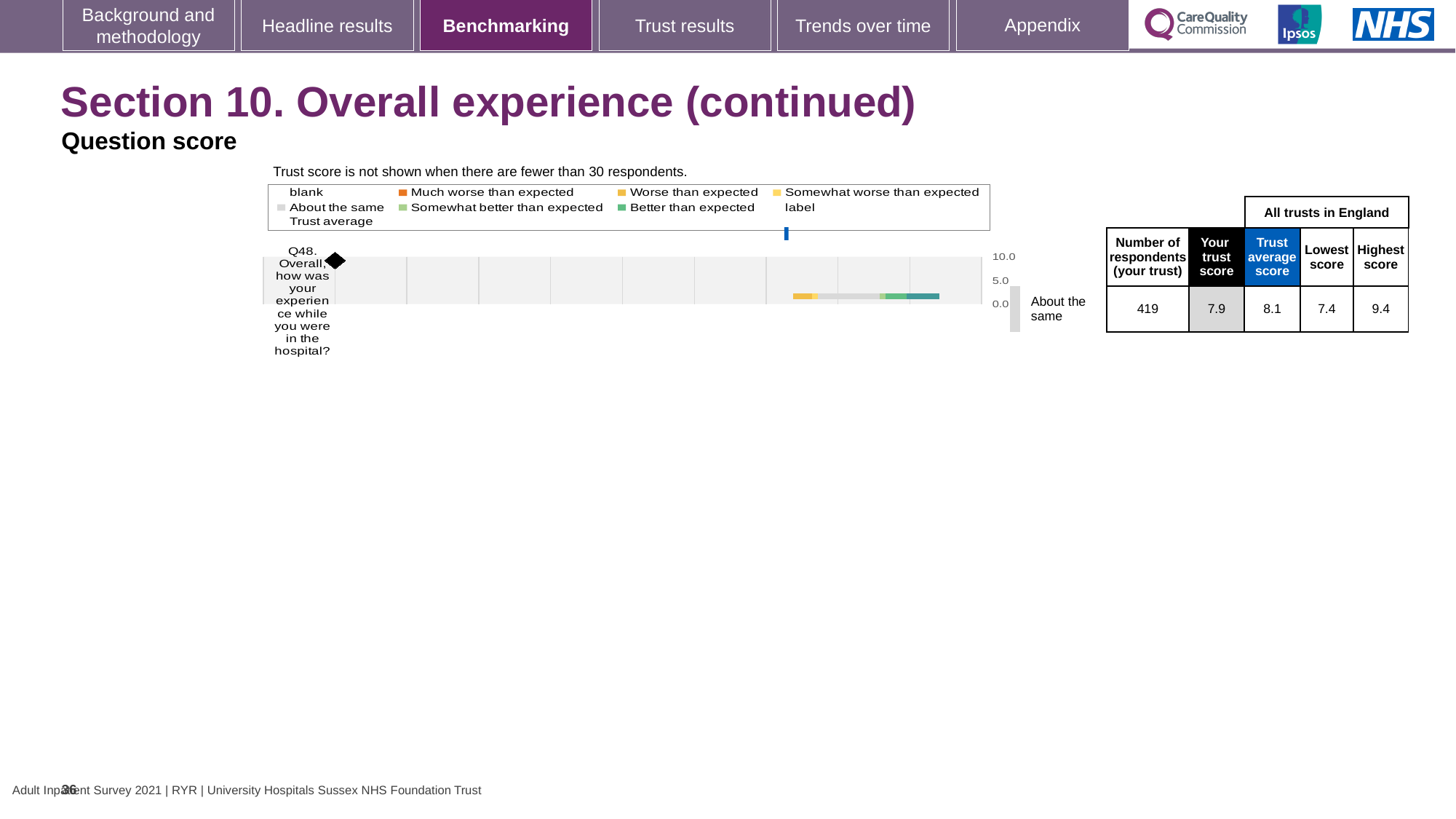
What is the number of respondents for Q48 at your trust? 419 What benchmark category is shown next to the bar for Q48? About the same Is your trust score for Q48 greater or less than 5.0 on the chart axis? greater What is the trust average score for Q48 across all trusts in England? 8.1 What kind of chart is shown on the slide? bar chart Which is larger for Q48, your trust score or the trust average score? Trust average score What is the lowest score for Q48 among all trusts in England? 7.4 Which question is plotted in the chart? Q48. Overall, how was your experience while you were in the hospital? How many survey questions are plotted in the chart? 1 What is the highest score for Q48 among all trusts in England? 9.4 What is your trust score for Q48? 7.9 What is the difference between the highest score and the lowest score for Q48? 2.0